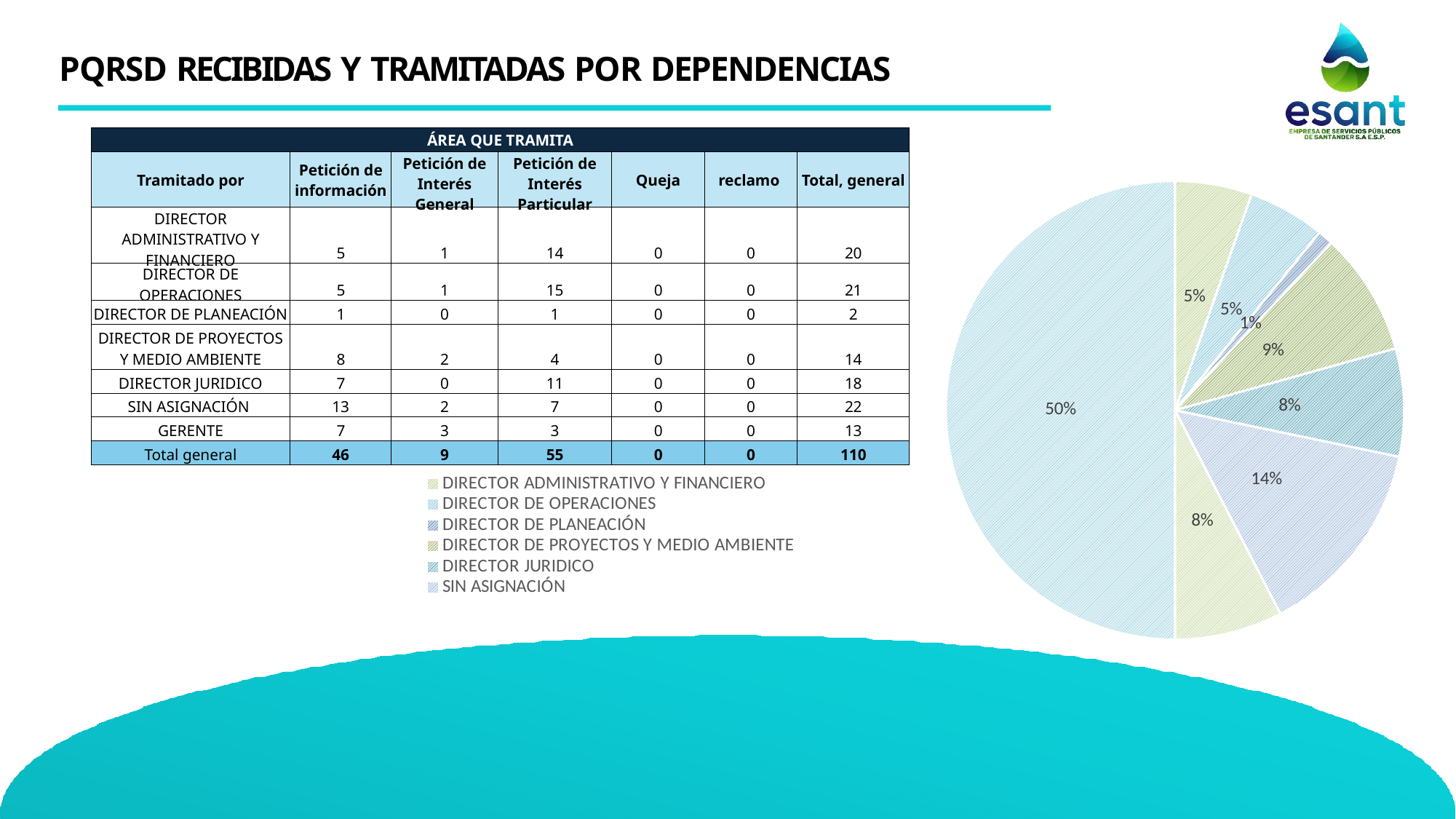
What percentage does the pie chart show for SIN ASIGNACIÓN? 14% What is the largest percentage shown on the pie chart? 50% How many entries does the pie chart's legend list? 6 What kind of chart is shown on the slide? pie chart Which is larger in the pie chart, the slice for SIN ASIGNACIÓN or the slice for DIRECTOR JURIDICO? SIN ASIGNACIÓN What percentage does the pie chart show for DIRECTOR DE PLANEACIÓN? 1% Which legend entry has the largest slice in the pie chart? SIN ASIGNACIÓN What percentage does the pie chart show for DIRECTOR DE PROYECTOS Y MEDIO AMBIENTE? 9% What percentage does the pie chart show for DIRECTOR JURIDICO? 8% How many slices does the pie chart have? 8 What is the difference in percentage points between the SIN ASIGNACIÓN slice and the DIRECTOR JURIDICO slice? 6% What is the smallest percentage shown on the pie chart? 1%